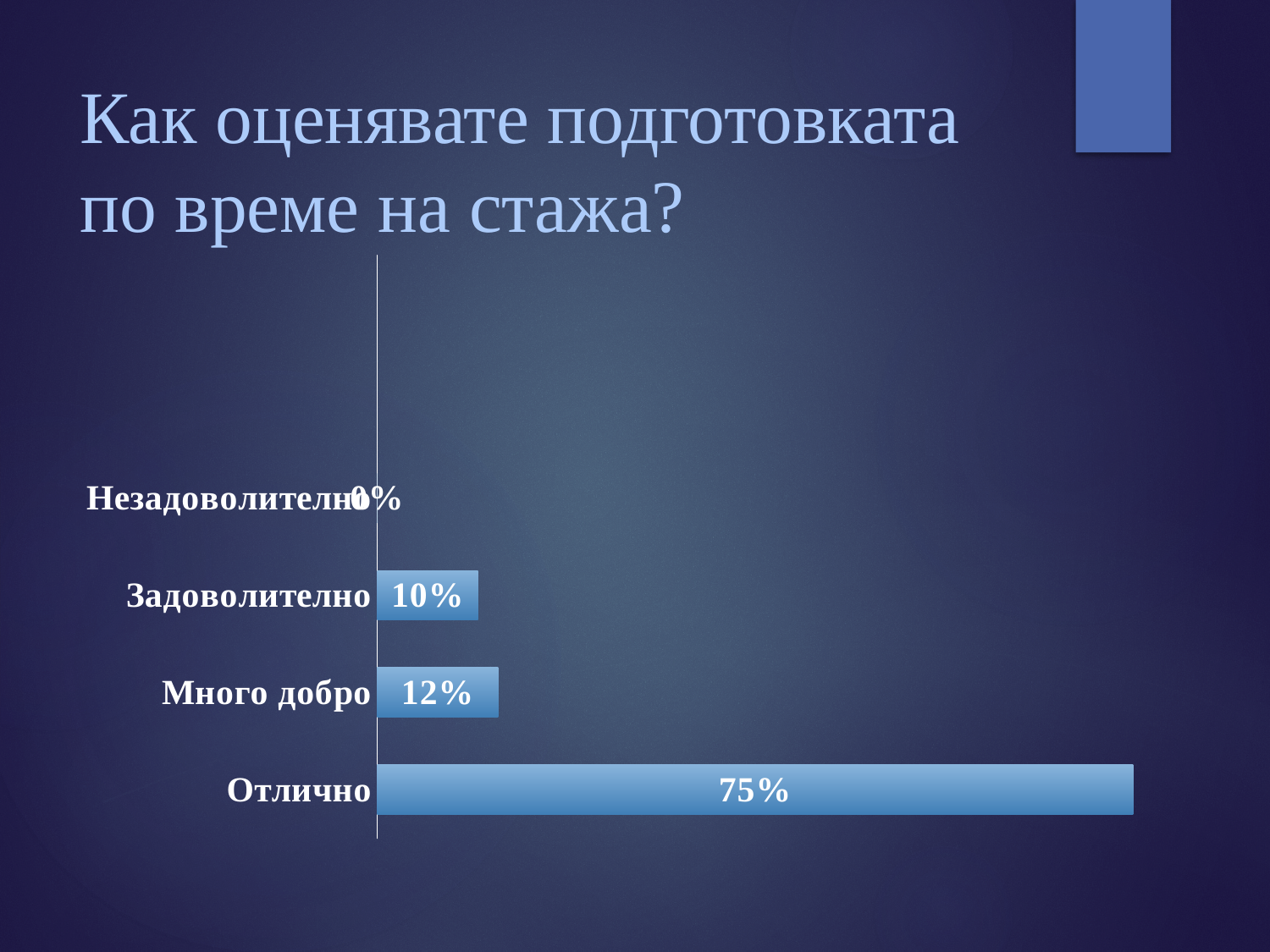
Which category has the lowest value? Незадоволително Which is larger, the value for Много добро or the value for Задоволително? Много добро What is the value for Много добро? 12% How many categories are shown in the chart? 4 What is the title of the slide containing the chart? Как оценявате подготовката по време на стажа? What is the value for Отлично? 75% What is the difference between the values for Отлично and Много добро? 63% What is the difference between the values for Много добро and Задоволително? 2% What is the value for Незадоволително? 0% What kind of chart is shown on the slide? Bar chart Which category has the highest value? Отлично What is the value for Задоволително? 10%